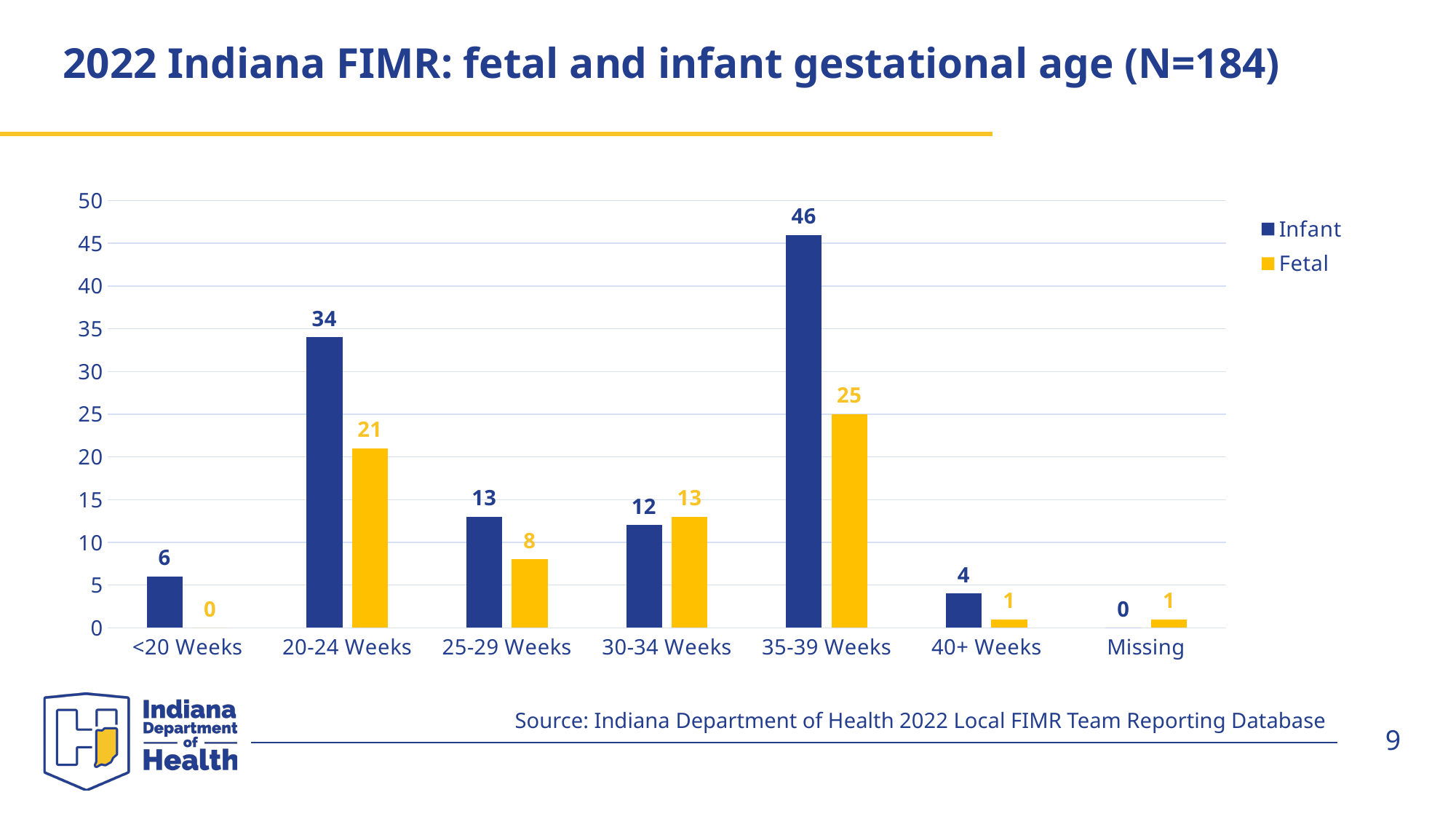
What kind of chart is shown on the slide? Bar chart What is the Infant value for 35-39 Weeks? 46 How many series does the legend list? 2 What is the Fetal value for <20 Weeks? 0 Which gestational age category has the lowest Infant value? Missing Which colour represents the Fetal series? Yellow What is the Fetal value for 20-24 Weeks? 21 Which is larger for 30-34 Weeks, the Infant value or the Fetal value? Fetal Is the Infant value for 20-24 Weeks greater or less than 30? greater What is the difference between the Infant and Fetal values for 35-39 Weeks? 21 Which gestational age category has the highest Infant value? 35-39 Weeks How many gestational age categories are shown on the x axis? 7